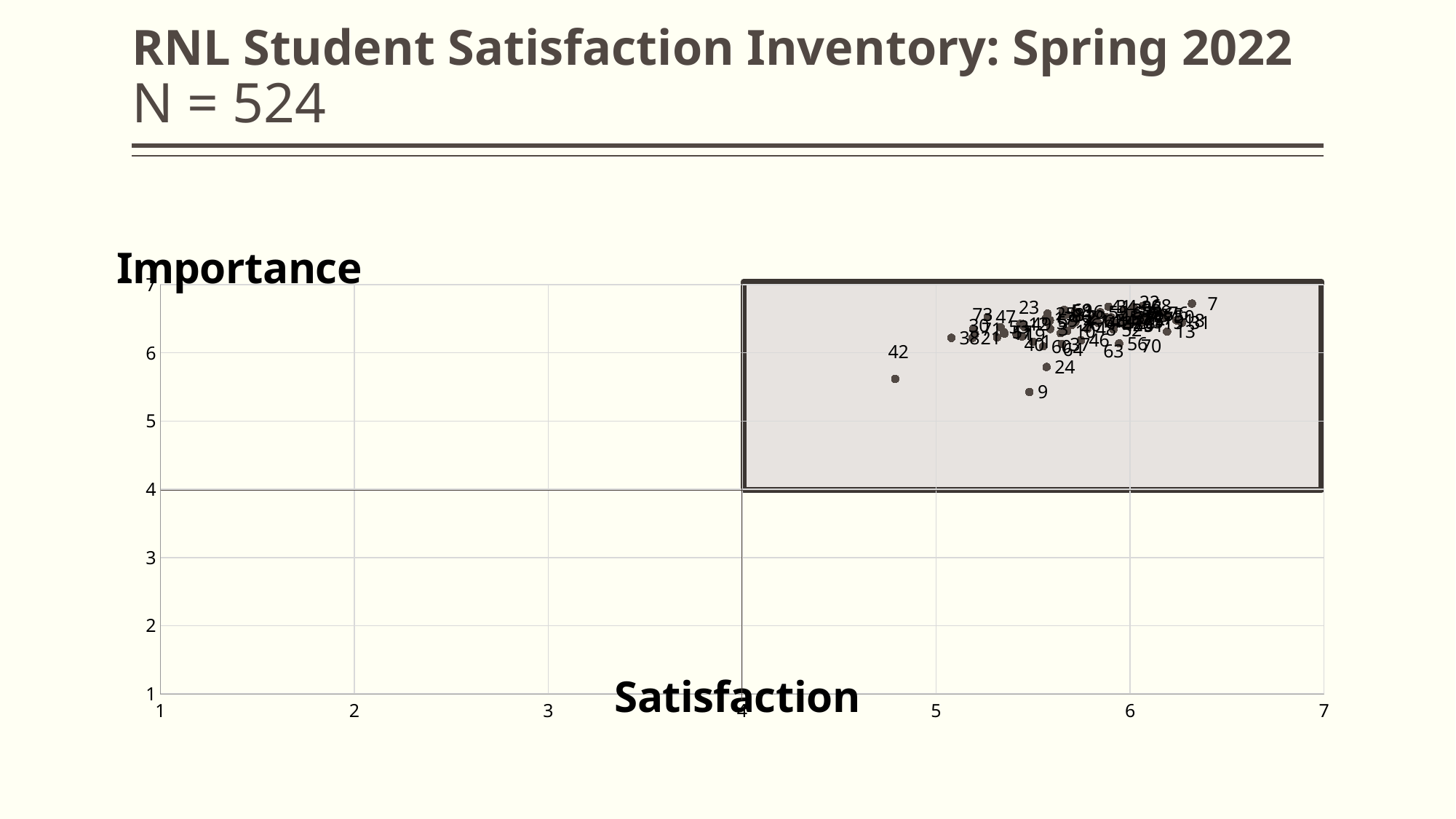
Is the Satisfaction value for point 42 greater or less than 5? less Is the Importance value for point 24 greater or less than 6? less Is the Importance value for point 9 greater or less than 6? less Which point has the higher Satisfaction value, point 42 or point 7? 7 What is the title of the chart on the slide? RNL Student Satisfaction Inventory: Spring 2022 Which labeled point has the lowest Importance value? 9 Which point has the higher Importance value, point 9 or point 24? 24 Which labeled point has the lowest Satisfaction value? 42 What kind of chart is shown on the slide? scatter plot What is the label of the vertical axis of the chart? Importance